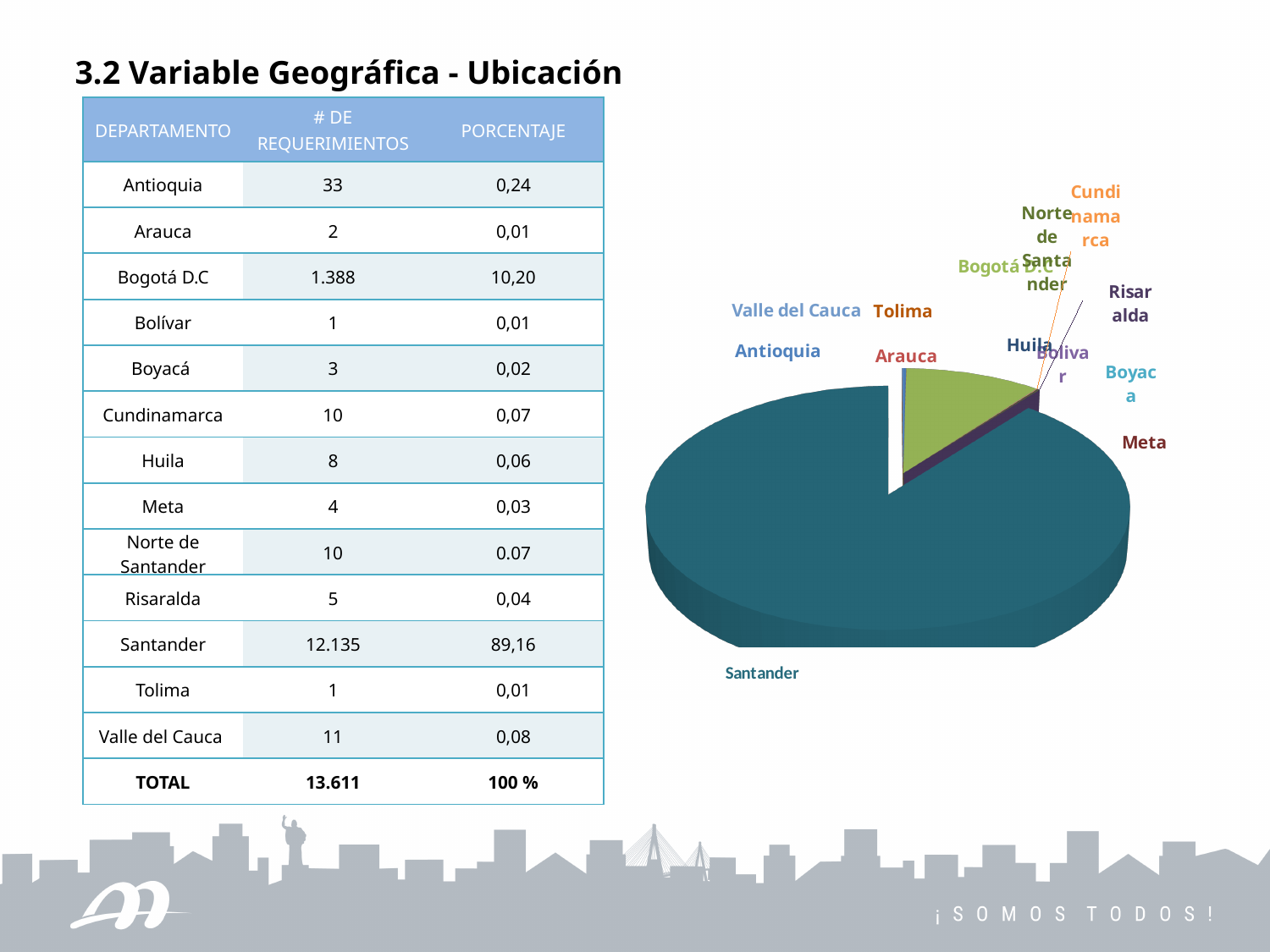
What is the total number of requerimientos across all departments? 13.611 Which has more requerimientos, Bogotá D.C or Antioquia? Bogotá D.C What percentage share does Santander have according to the slide? 89,16 Which department has the largest slice of the pie chart? Santander Which department's slice is coloured green in the pie chart? Bogotá D.C What is the difference in requerimientos between Santander and Bogotá D.C? 10.747 What is the title of the slide? 3.2 Variable Geográfica - Ubicación How many requerimientos does Bogotá D.C have? 1.388 What kind of chart is shown on the slide? pie chart How many requerimientos does Valle del Cauca have? 11 How many requerimientos does Arauca have? 2 How many departments are shown as slices in the pie chart? 13